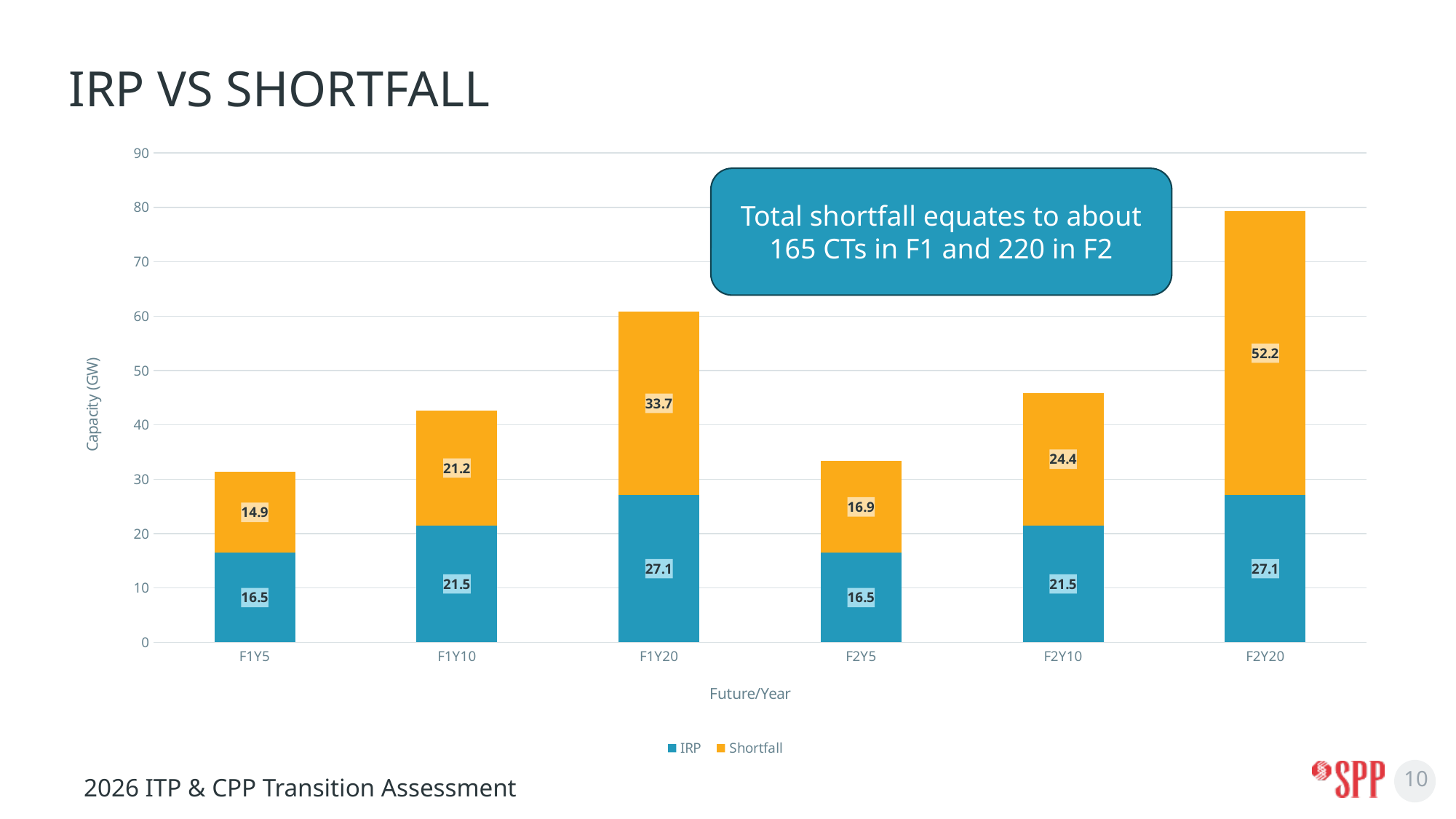
What is the IRP value for F2Y10? 21.5 What is the total of the stacked bar for F1Y10? 42.7 Which is larger, the Shortfall for F2Y10 or the Shortfall for F1Y10? F2Y10 Which category has the highest Shortfall value? F2Y20 What is the difference between the Shortfall values for F2Y20 and F1Y20? 18.5 What kind of chart is shown on the slide? Stacked bar chart Is the total stacked value for F2Y20 greater or less than 70? greater What is the Shortfall value for F1Y20? 33.7 How many categories are shown on the x axis? 6 Which category has the lowest Shortfall value? F1Y5 How many series does the legend list? 2 What is the label of the y axis? Capacity (GW)